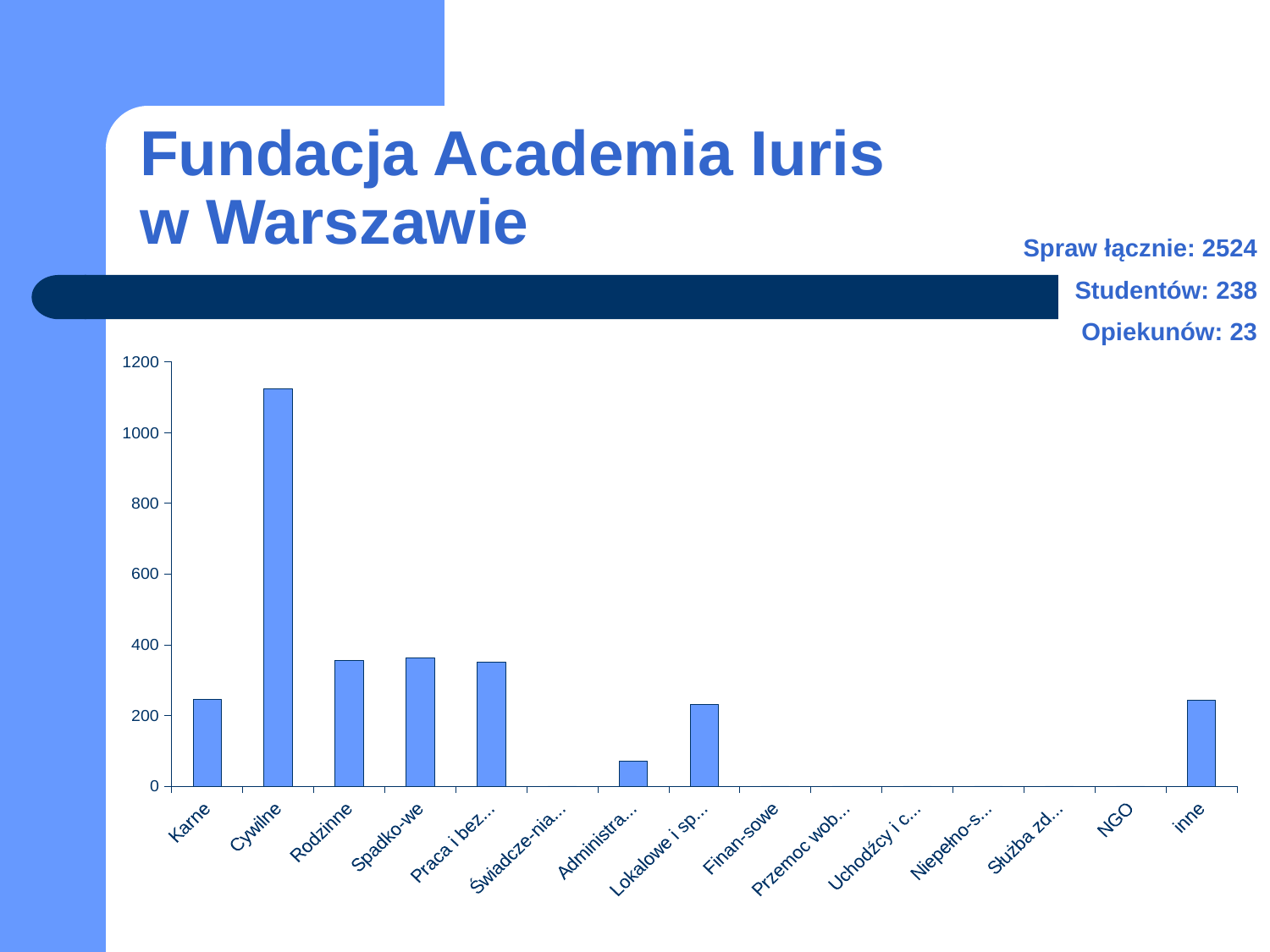
What is the highest value shown on the vertical axis of the chart? 1200 Is the value for Cywilne greater or less than 1000? greater Is the value for Karne greater or less than 200? greater What is the title of the slide containing the chart? Fundacja Academia Iuris w Warszawie Which is larger, the value for Cywilne or the value for Rodzinne? Cywilne Is the value for Lokalowe i sp... greater or less than 200? greater Which is larger, the value for Administra... or the value for Lokalowe i sp...? Lokalowe i sp... How many categories are shown on the x axis of the chart? 15 Which category has the highest bar in the chart? Cywilne What kind of chart is shown on the slide? bar chart